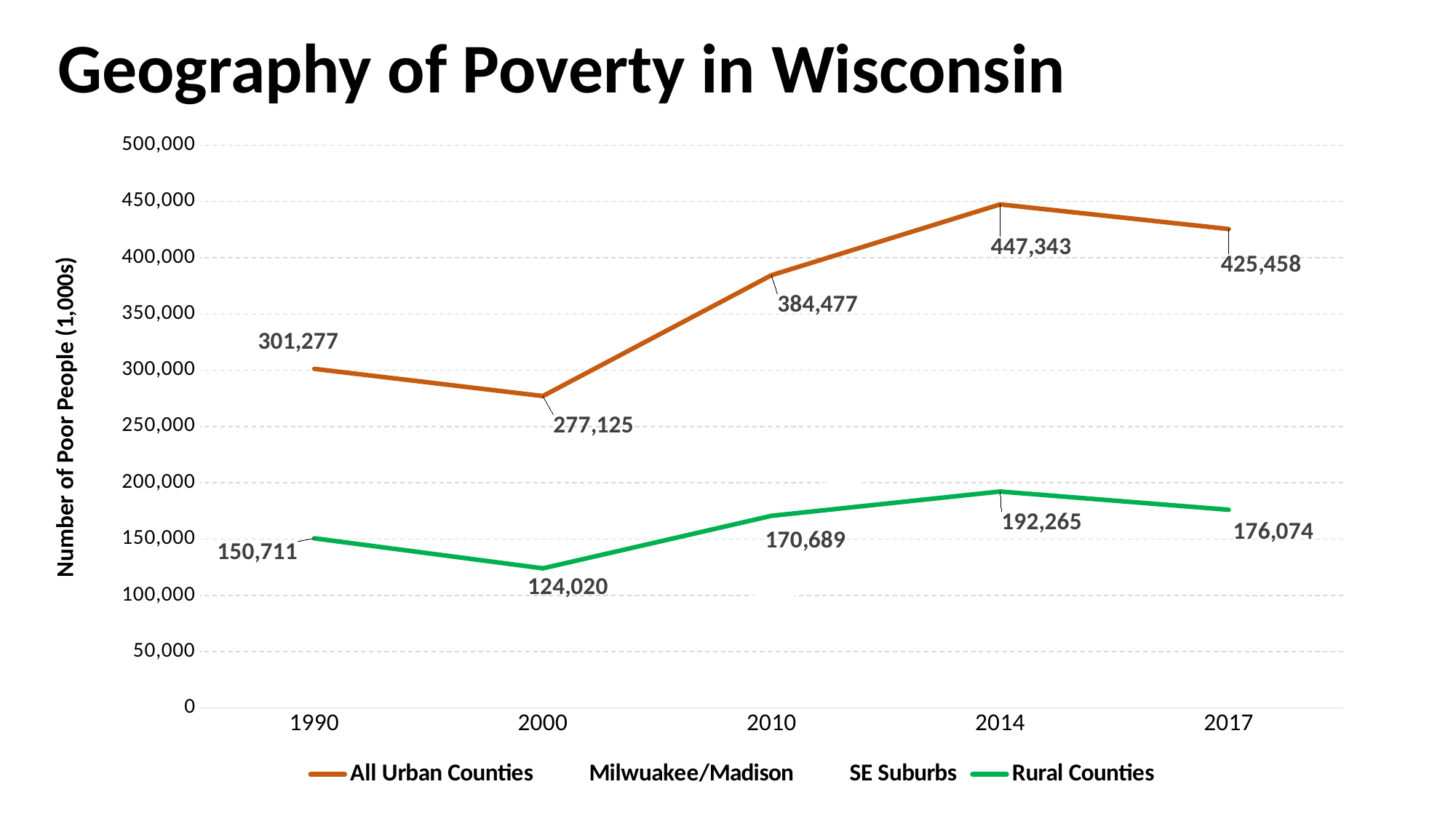
What kind of chart is shown on the slide? Line chart What is the value for All Urban Counties in 2014? 447,343 How many years are plotted on the x axis? 5 Which year has the larger All Urban Counties value, 1990 or 2000? 1990 How many series does the legend list? 4 In which year is the Rural Counties value lowest? 2000 What is the title of the y axis? Number of Poor People (1,000s) In which year is the All Urban Counties value highest? 2014 What is the difference between the All Urban Counties and Rural Counties values in 2017? 249,384 Does the Rural Counties value rise or fall from 2000 to 2014? Rise How much did the Rural Counties value increase from 1990 to 2014? 41,554 What is the value for Rural Counties in 2000? 124,020